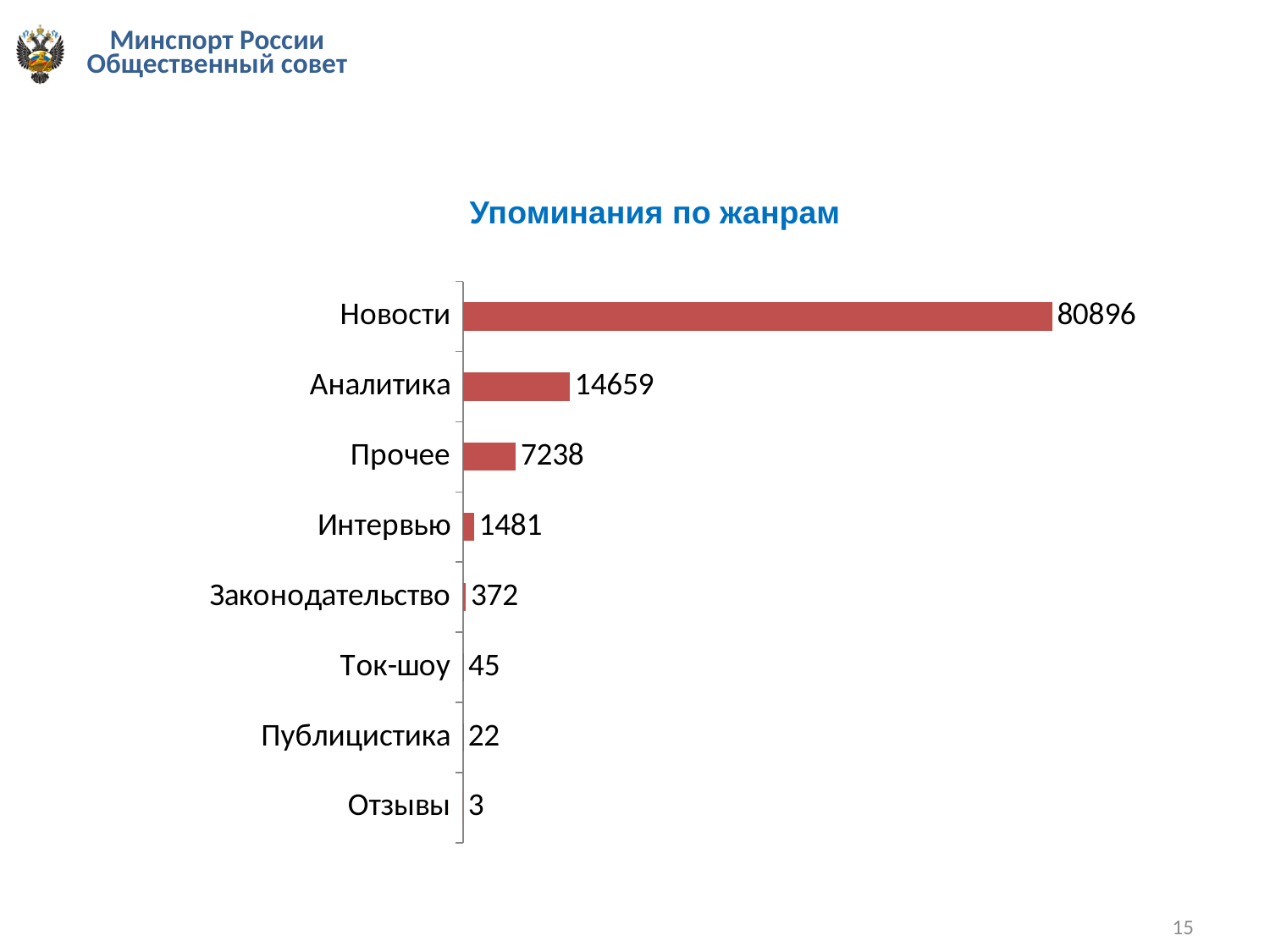
What is the value for Законодательство? 372 What is the value for Новости? 80896 What is the difference between the values for Новости and Аналитика? 66237 Which category has the highest value? Новости How many categories are shown in the chart? 8 Which is larger, the value for Ток-шоу or the value for Публицистика? Ток-шоу What is the title of the chart? Упоминания по жанрам What is the difference between the values for Прочее and Интервью? 5757 What is the value for Аналитика? 14659 Which category has the lowest value? Отзывы What kind of chart is shown on the slide? Bar chart What is the value for Интервью? 1481